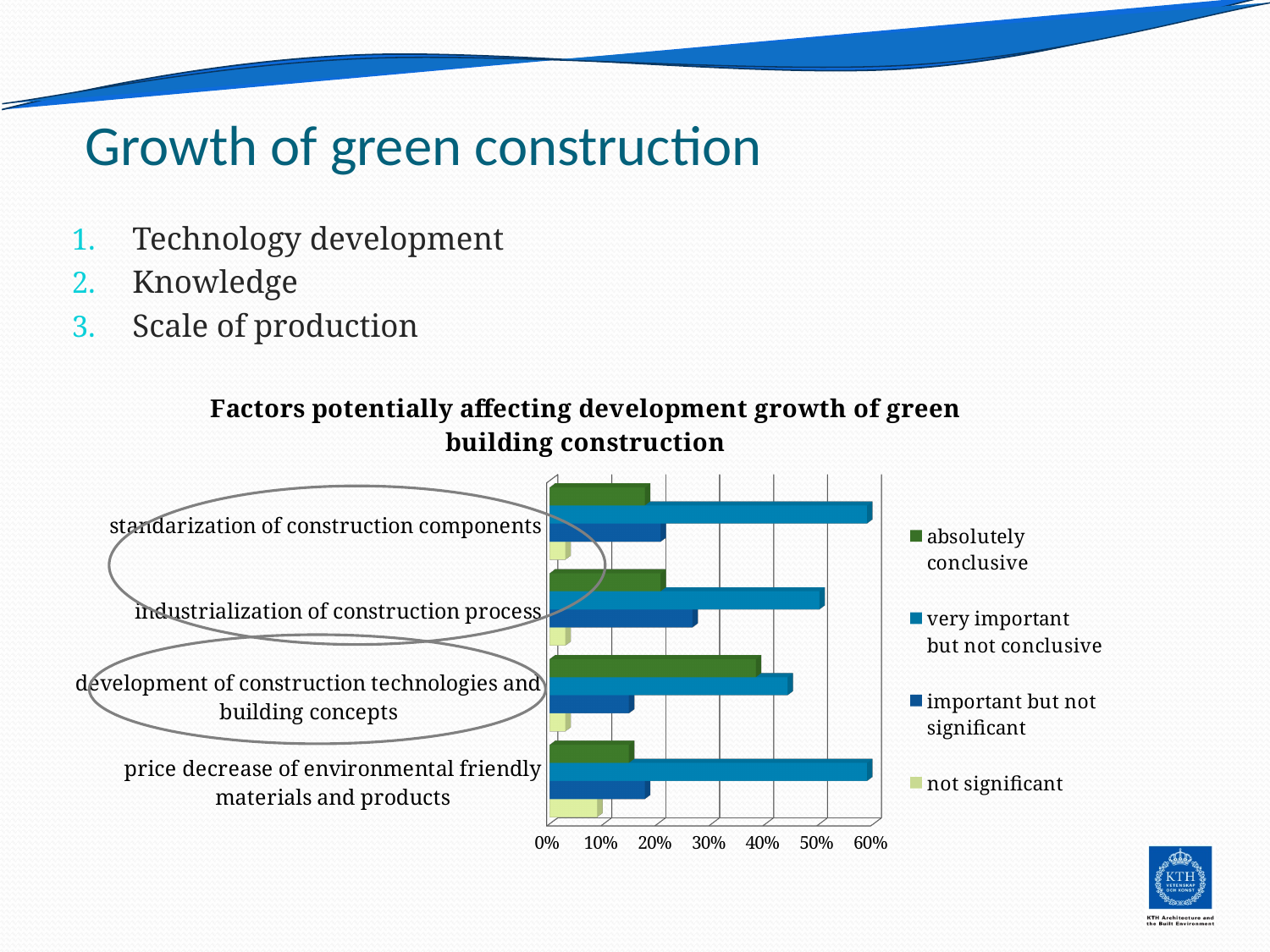
Which category has the highest 'not significant' value? price decrease of environmental friendly materials and products How many series does the chart's legend list? 4 Which category has the lowest 'very important but not conclusive' value? development of construction technologies and building concepts How many categories (factors) are plotted on the chart? 4 Which category has the highest 'absolutely conclusive' value? development of construction technologies and building concepts Is the 'important but not significant' value for 'industrialization of construction process' greater or less than 20%? greater Is the 'very important but not conclusive' value for 'standarization of construction components' greater or less than 50%? greater What kind of chart is shown on the slide? bar chart What is the title of the chart? Factors potentially affecting development growth of green building construction For 'development of construction technologies and building concepts', which is larger: the 'absolutely conclusive' value or the 'important but not significant' value? absolutely conclusive Is the 'absolutely conclusive' value for 'development of construction technologies and building concepts' greater or less than 30%? greater